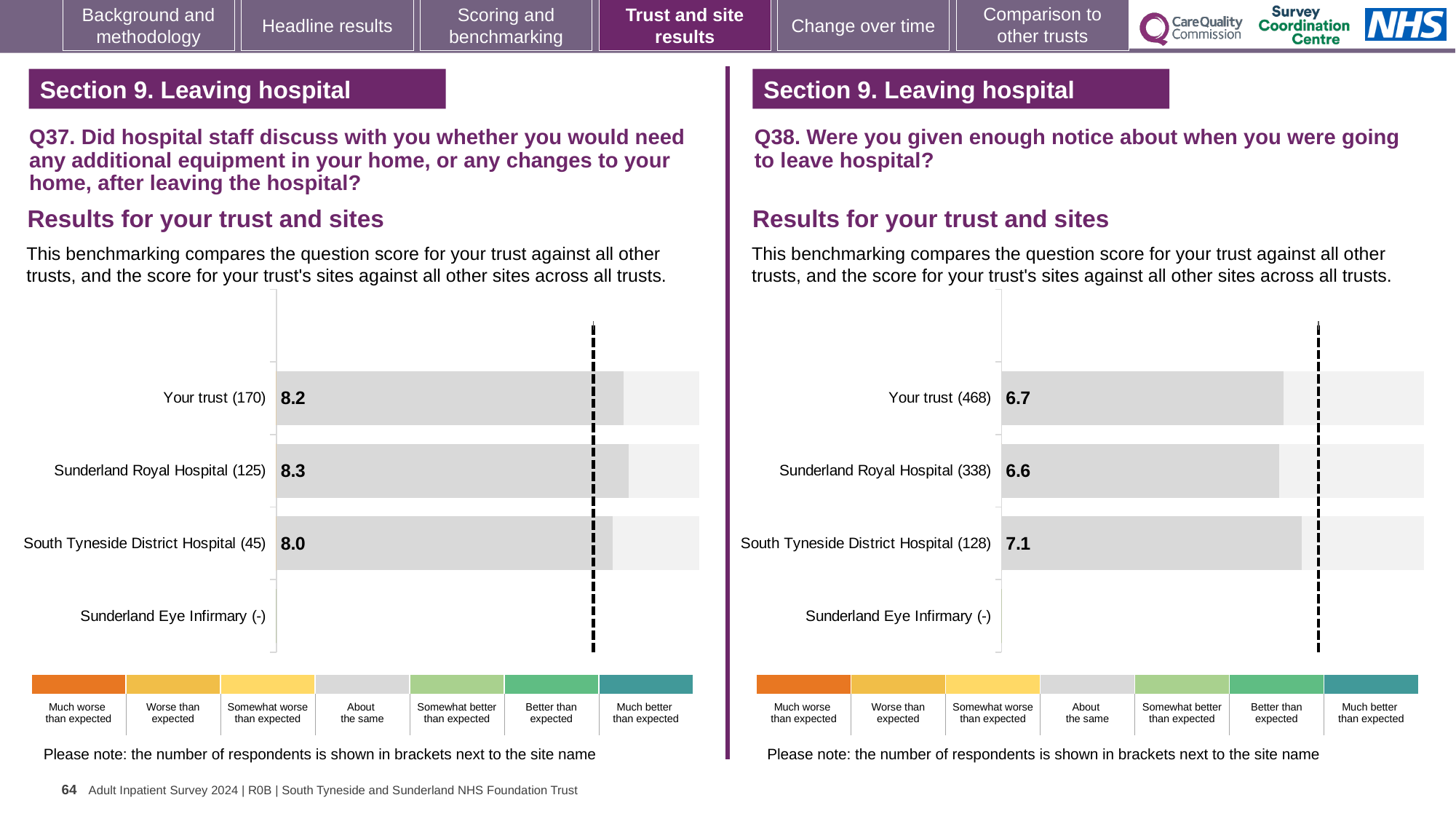
On the Q38 chart, what is the score for South Tyneside District Hospital? 7.1 On the Q38 chart, what is the difference between the scores for South Tyneside District Hospital and Sunderland Royal Hospital? 0.5 On the Q37 chart, what is the difference between the scores for Sunderland Royal Hospital and South Tyneside District Hospital? 0.3 What kind of chart is used on the Q37 side of the slide? bar chart On the Q37 chart, how many respondents are shown in brackets for Sunderland Royal Hospital? 125 On the Q37 chart, which site or trust has the highest score? Sunderland Royal Hospital On the Q38 chart, which site or trust has the lowest score? Sunderland Royal Hospital On the Q38 chart, what is the score for Your trust? 6.7 On the Q38 chart, is the score for South Tyneside District Hospital larger or smaller than the score for Your trust? larger On the Q37 chart, what is the score for South Tyneside District Hospital? 8.0 On the Q37 chart, what is the score for Your trust? 8.2 On the Q38 chart, how many sites or trusts have a score printed? 3